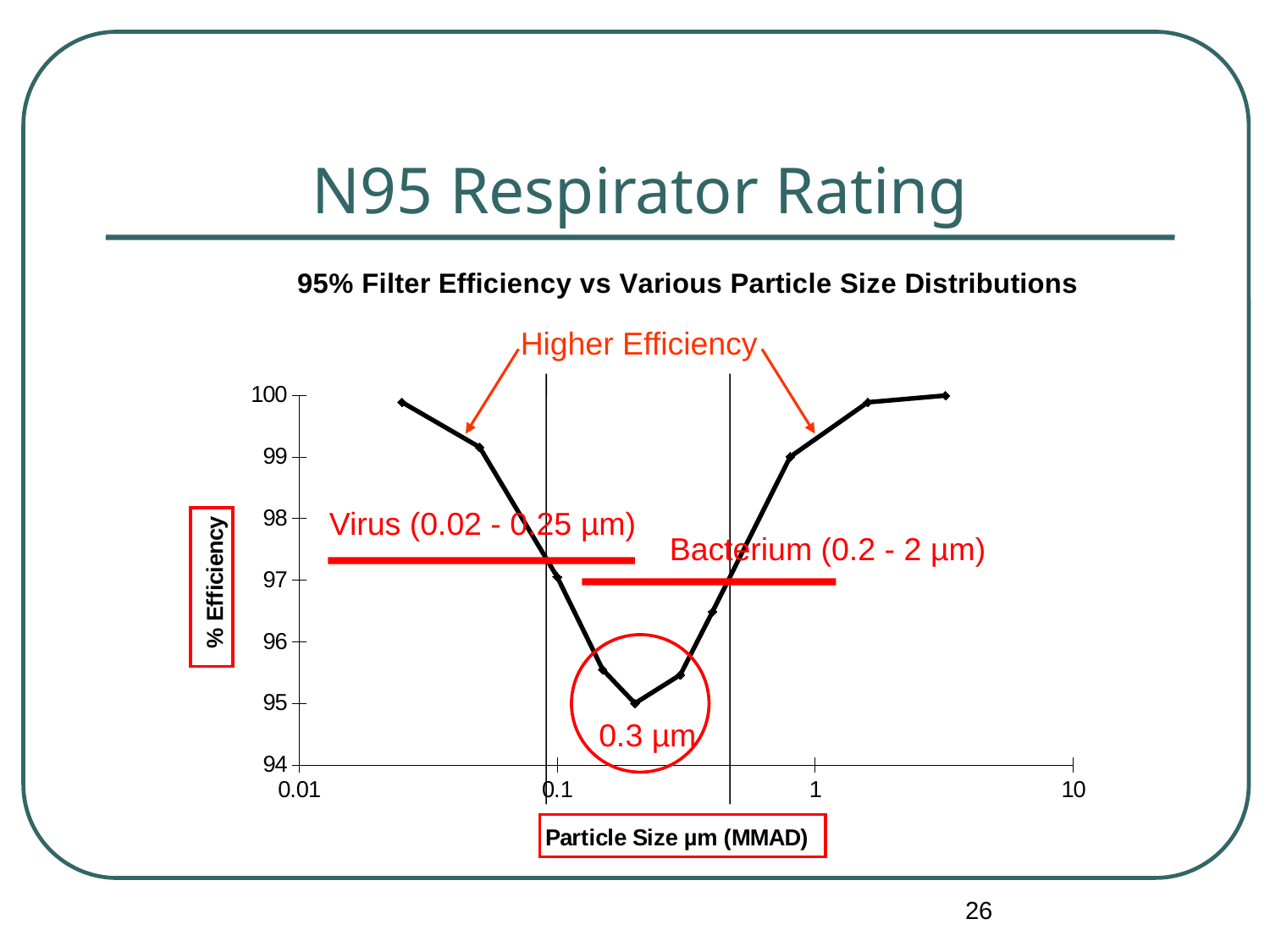
Which has the higher efficiency: the smallest plotted particle size or 0.3 µm? the smallest plotted particle size At which particle size does the chart mark the lowest filter efficiency? 0.3 µm Is the lowest efficiency value on the curve greater or less than 96? less What is the title of the chart? 95% Filter Efficiency vs Various Particle Size Distributions Does the efficiency rise or fall as particle size increases from the smallest plotted size to 0.3 µm? fall Does the efficiency rise or fall as particle size increases from 0.3 µm to the largest plotted size? rise Is the efficiency at the largest plotted particle size greater or less than 99? greater What is the label of the x axis of the chart? Particle Size µm (MMAD) What kind of chart is shown on the slide? line chart Is the efficiency at 0.1 µm greater or less than 96? greater